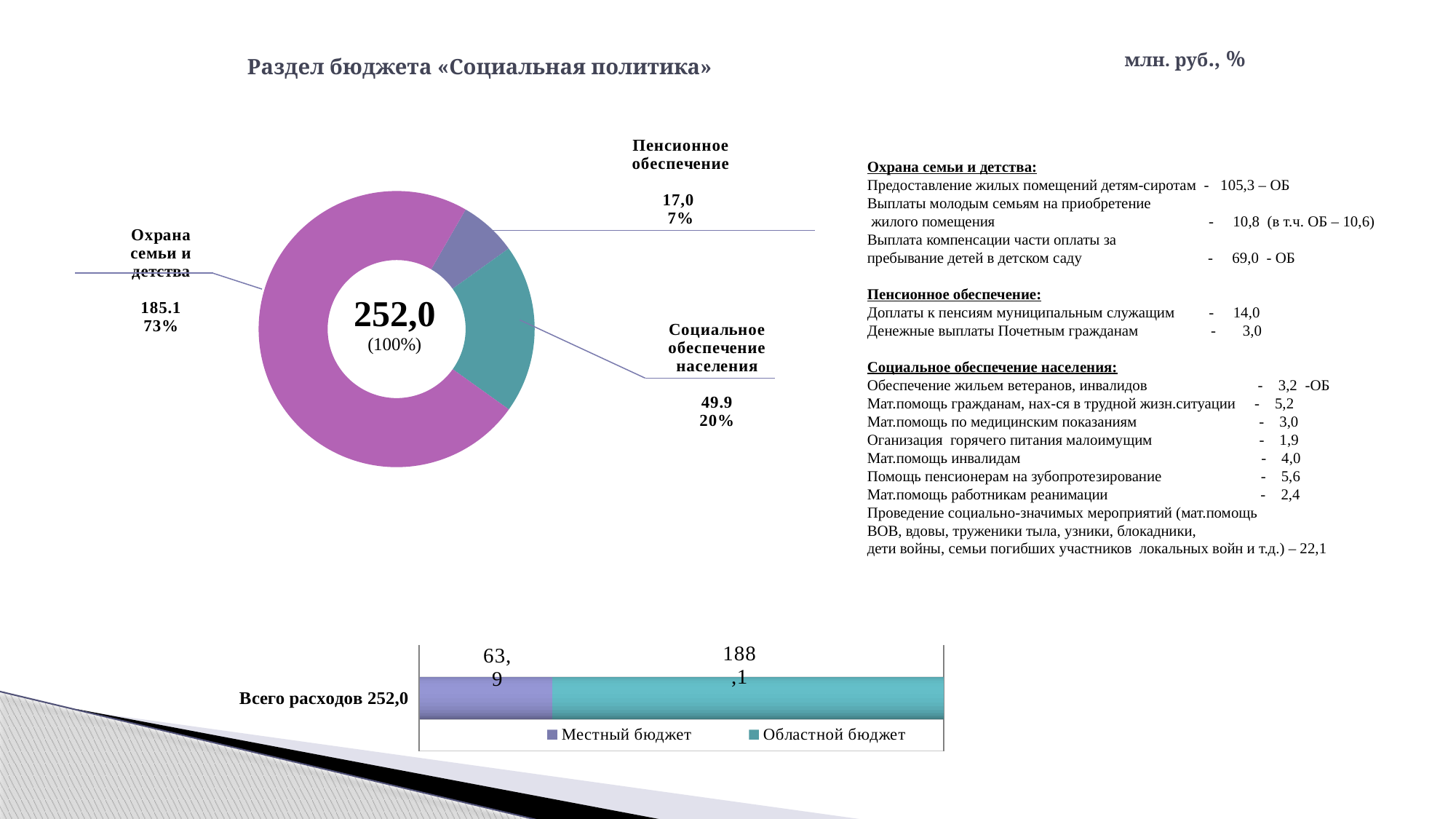
In the donut chart, what total value is printed in the centre? 252,0 In the donut chart, what value is shown for «Социальное обеспечение населения»? 49.9 In the donut chart, which is larger: «Социальное обеспечение населения» or «Пенсионное обеспечение»? Социальное обеспечение населения In the donut chart, what value is shown for «Охрана семьи и детства»? 185.1 In the bottom bar chart, what value is shown for «Областной бюджет»? 188,1 In the donut chart, which category has the largest share? Охрана семьи и детства In the donut chart, which category has the smallest share? Пенсионное обеспечение How many categories does the donut chart show? 3 How many series does the legend of the bottom bar chart list? 2 What type of chart is shown at the bottom of the slide? Stacked bar chart In the donut chart, what percentage share is shown for «Пенсионное обеспечение»? 7% In the bottom bar chart, what value is shown for «Местный бюджет»? 63,9